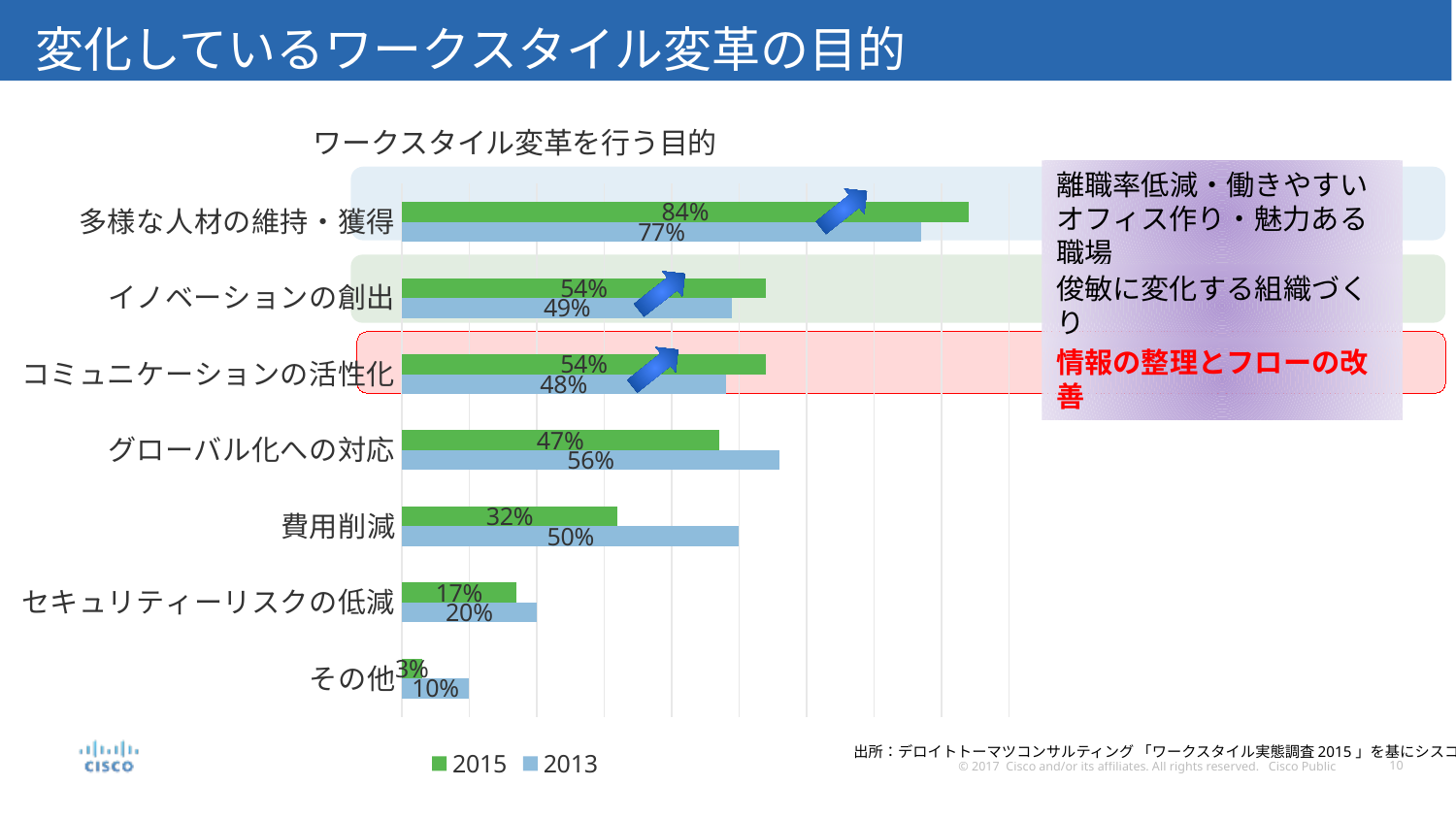
Which category has the lowest 2013 value? その他 Which category has the highest 2015 value? 多様な人材の維持・獲得 For グローバル化への対応, which year has the larger value, 2015 or 2013? 2013 How many categories are shown in the chart? 7 What is the 2013 value for グローバル化への対応? 56% What is the 2015 value for セキュリティーリスクの低減? 17% What is the 2013 value for 費用削減? 50% What is the 2015 value for 多様な人材の維持・獲得? 84% What is the difference between the 2015 and 2013 values for 多様な人材の維持・獲得? 7% How many series does the legend list? 2 What is the difference between the 2015 and 2013 values for 費用削減? 18% What type of chart is shown on the slide? Bar chart